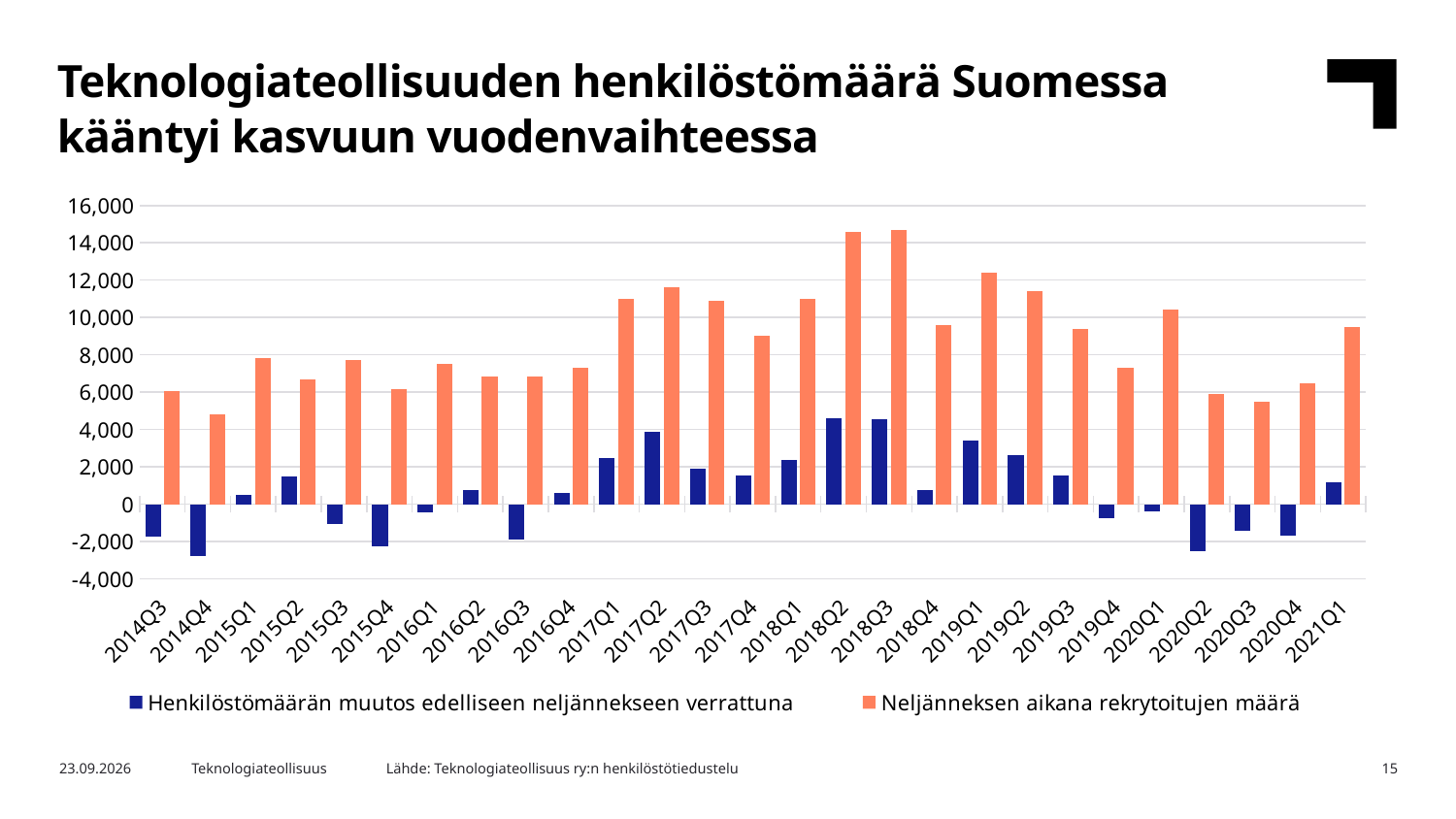
How many quarters are shown on the x axis? 27 How many series does the legend list? 2 What kind of chart is shown on the slide? Bar chart Is the value for Neljänneksen aikana rekrytoitujen määrä in 2020Q3 greater or less than 6,000? less Is the value for Neljänneksen aikana rekrytoitujen määrä in 2017Q1 greater or less than 10,000? greater Which is larger for Neljänneksen aikana rekrytoitujen määrä: 2018Q2 or 2017Q4? 2018Q2 Which is larger for Henkilöstömäärän muutos edelliseen neljännekseen verrattuna: 2019Q1 or 2019Q3? 2019Q1 Is the value for Henkilöstömäärän muutos edelliseen neljännekseen verrattuna in 2020Q2 greater or less than -2,000? less Does the value for Neljänneksen aikana rekrytoitujen määrä rise or fall from 2019Q1 to 2020Q3? fall Which colour represents Neljänneksen aikana rekrytoitujen määrä in the chart? Orange Which quarter has the lowest value for Neljänneksen aikana rekrytoitujen määrä? 2014Q4